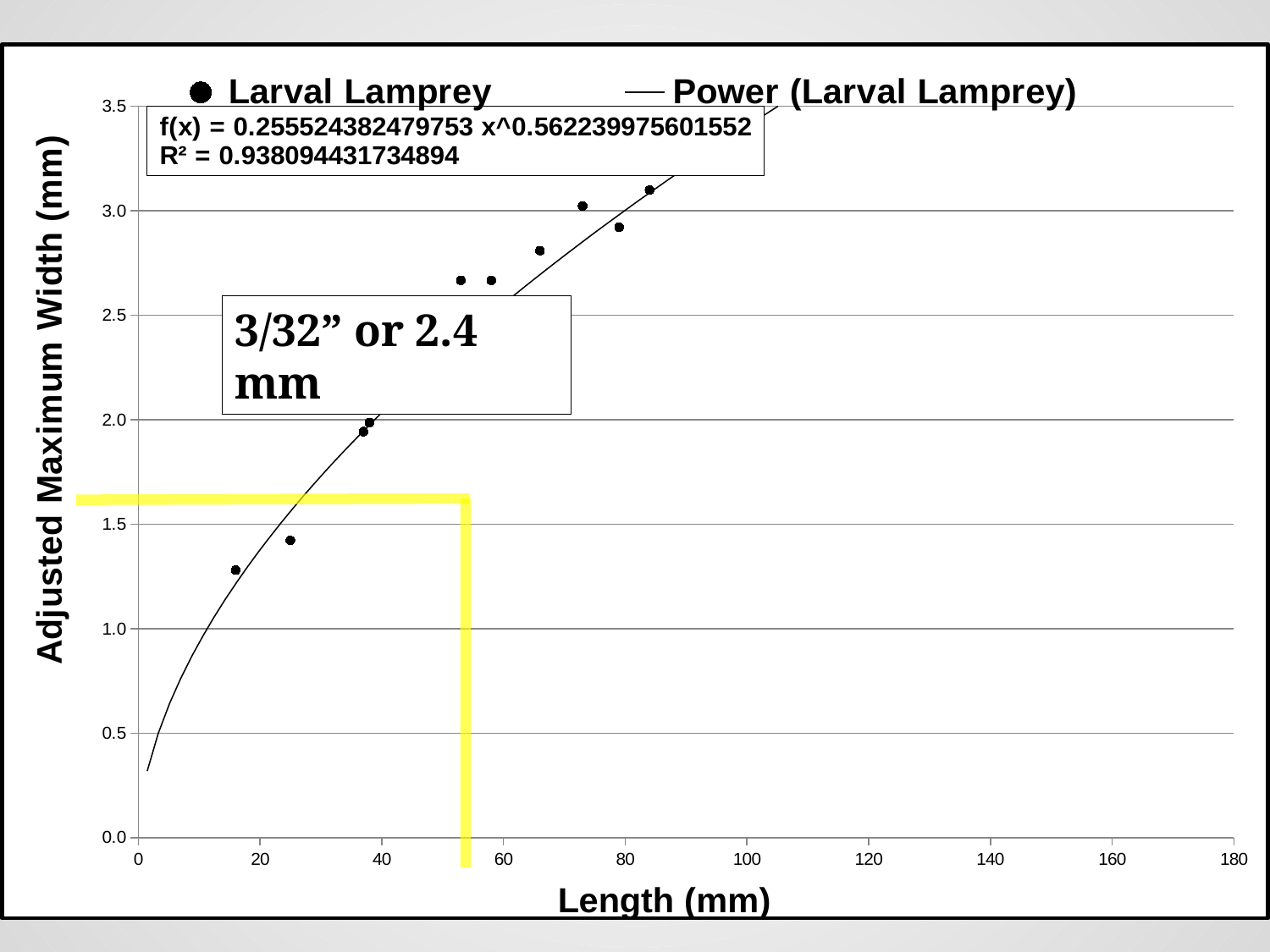
Do the Larval Lamprey data points generally rise or fall as Length increases? Rise What is the label of the y axis? Adjusted Maximum Width (mm) What width does the text box on the chart state as equivalent to 3/32 inch? 2.4 mm What kind of chart is shown on the slide? Scatter chart Is the adjusted maximum width of the data point at the largest length (around 84 mm) greater or less than 3.0? greater What R² value is printed on the chart? R² = 0.938094431734894 Which data point has the lowest adjusted maximum width: the one at about 16 mm length or the one at about 84 mm length? The one at about 16 mm length What is the highest value shown on the x axis? 180 How many entries does the legend list? 2 What is the exponent in the fitted power equation printed on the chart? 0.562239975601552 Is the adjusted maximum width of the data point at the smallest length (around 16 mm) greater or less than 1.5? less What is the label of the x axis? Length (mm)